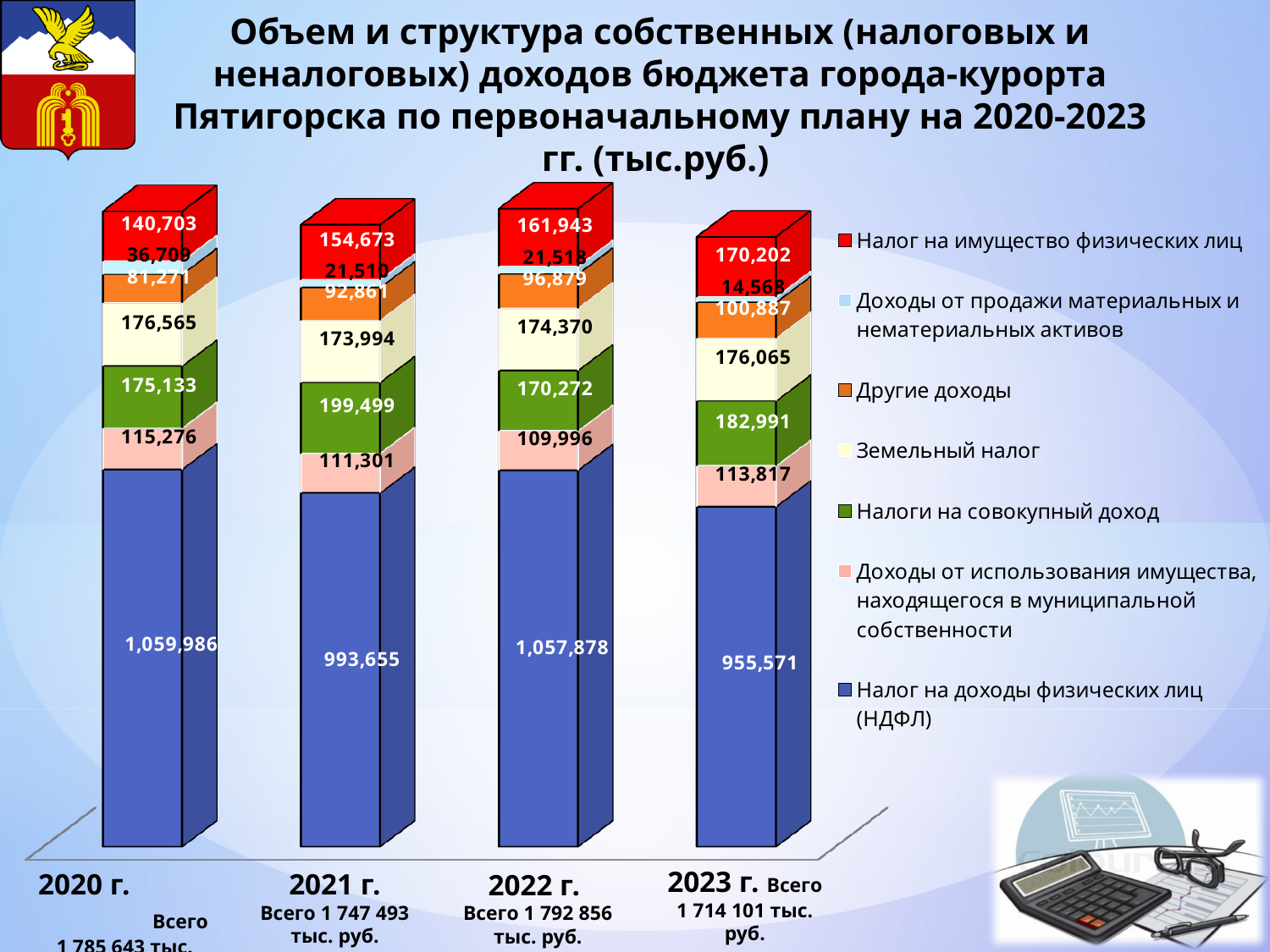
What kind of chart is shown on the slide? Stacked bar chart In which year is Доходы от продажи материальных и нематериальных активов the lowest? 2023 г. In which year is Налоги на совокупный доход the highest? 2021 г. What is the value of Налог на доходы физических лиц (НДФЛ) for 2020 г.? 1,059,986 What is the value of Земельный налог for 2022 г.? 174,370 What is the value of Налог на имущество физических лиц for 2023 г.? 170,202 What is the value of Доходы от продажи материальных и нематериальных активов for 2021 г.? 21,510 What is the total (Всего) for 2022 г.? 1 792 856 тыс. руб. What is the difference between Другие доходы in 2023 г. and in 2020 г.? 19,616 How many years are shown on the x axis? 4 Which is larger: Налог на доходы физических лиц (НДФЛ) in 2021 г. or in 2022 г.? 2022 г. How many series does the legend list? 7